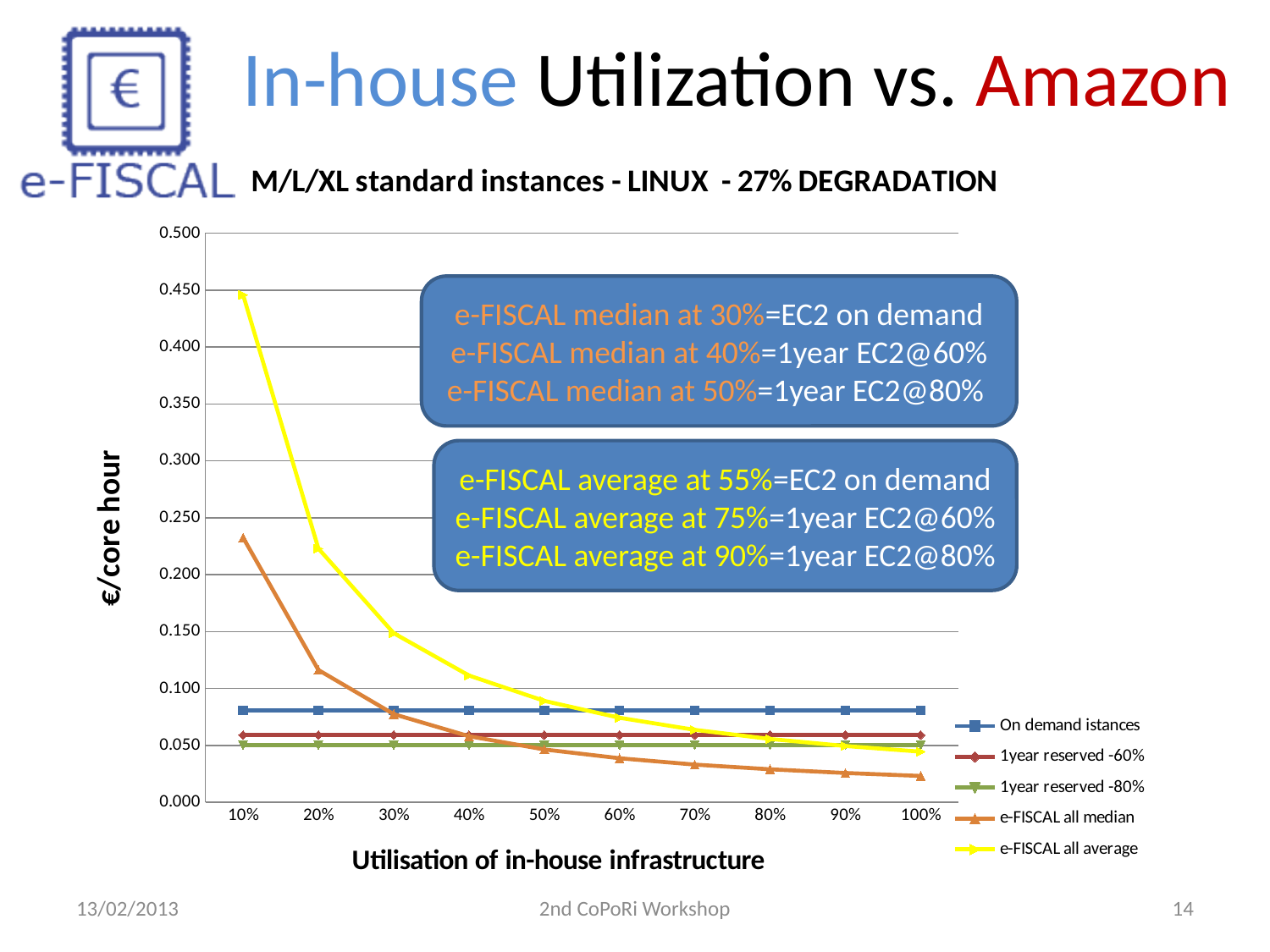
What is the title of the chart? M/L/XL standard instances - LINUX - 27% DEGRADATION Is the value for e-FISCAL all median at 100% utilisation greater or less than 0.050? less Does the e-FISCAL all average line rise or fall as utilisation increases from 10% to 100%? fall Is the value for e-FISCAL all median at 10% utilisation greater or less than 0.200? greater How many utilisation levels are shown along the x axis? 10 What is the label of the y axis? €/core hour What kind of chart is shown on the slide? line chart How many series does the chart legend list? 5 At 10% utilisation, which series has the highest value? e-FISCAL all average Is the value for On demand istances greater or less than 0.100? less Does the On demand istances line rise, fall or stay flat across the utilisation levels? stay flat